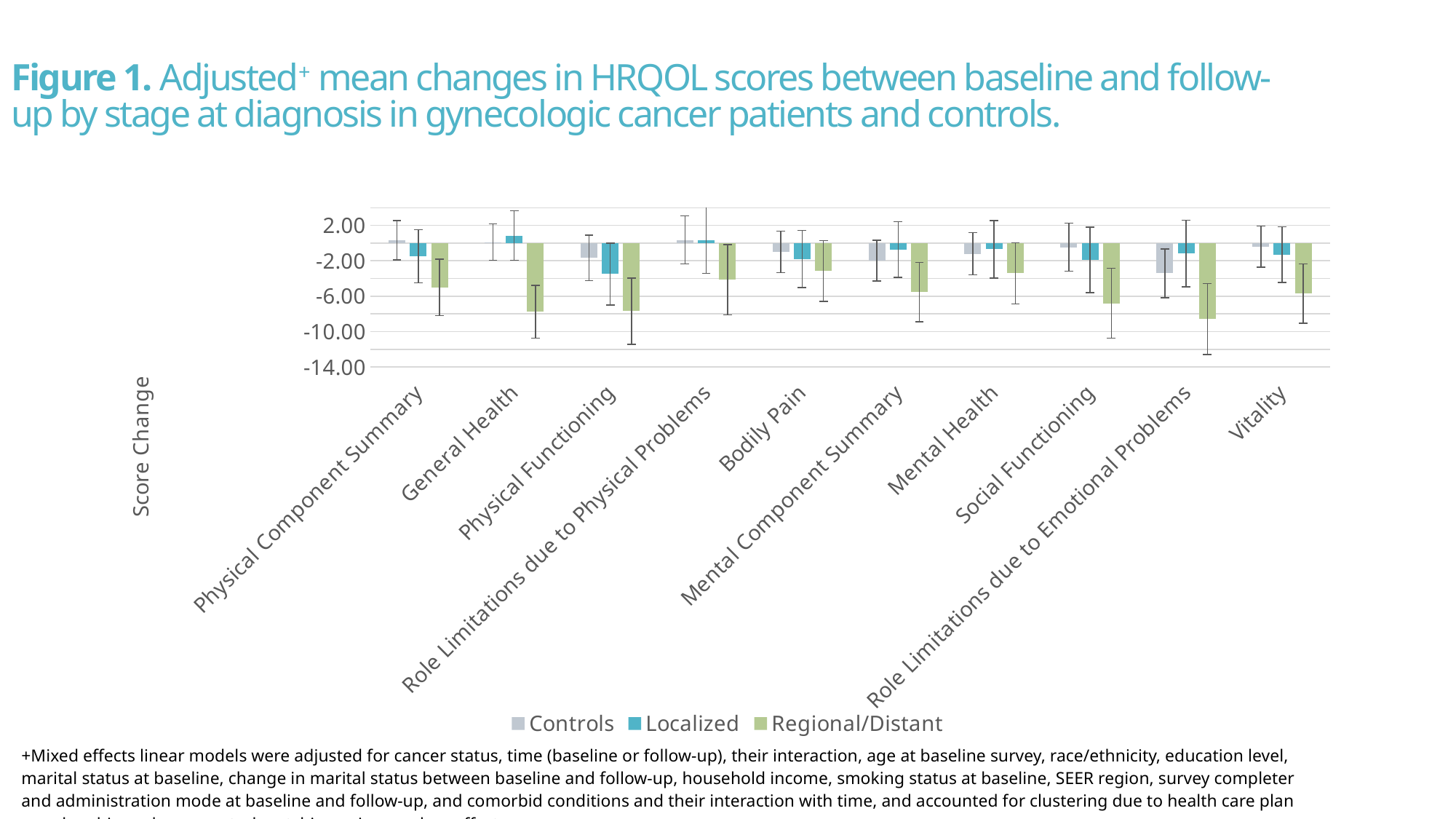
For Physical Functioning, which is larger: the Controls value or the Regional/Distant value? Controls What are the three series listed in the chart's legend? Controls, Localized, Regional/Distant How many categories are shown along the x axis of the chart? 10 Is the Regional/Distant value for Physical Functioning greater or less than -6.00? less For General Health, which is larger: the Localized value or the Regional/Distant value? Localized How many series does the chart's legend list? 3 Is the Regional/Distant value for Bodily Pain greater or less than -6.00? greater What kind of chart is shown on the slide? Bar chart What is the label on the vertical axis of the chart? Score Change Is the Regional/Distant value for General Health greater or less than -6.00? less